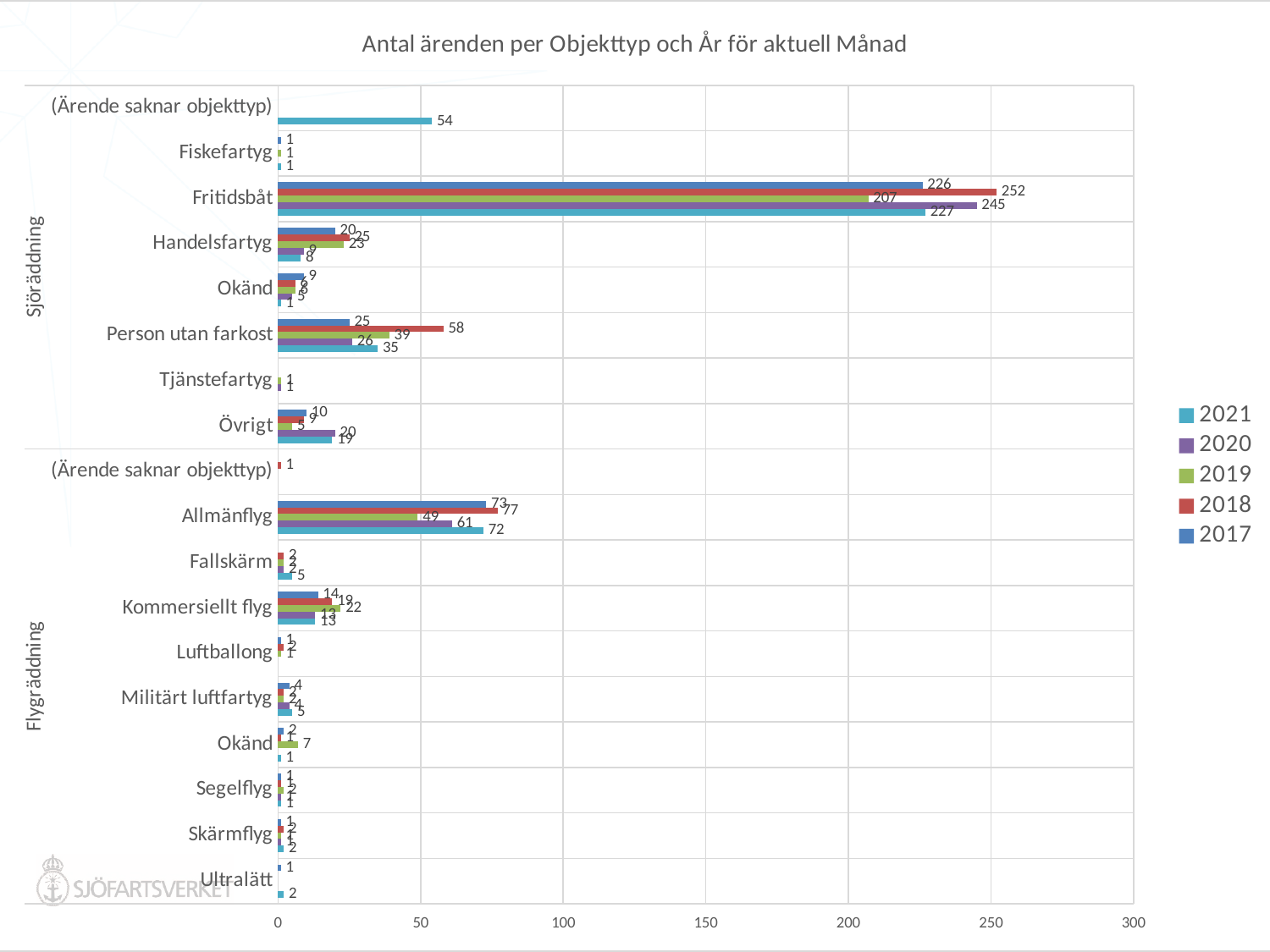
How many series does the legend list? 5 For Person utan farkost, which year has the larger value, 2018 or 2019? 2018 Which year has the highest value for Fritidsbåt? 2018 What is the difference between the 2018 and 2021 values for Allmänflyg? 5 What is the 2021 value for (Ärende saknar objekttyp) under Sjöräddning? 54 Which year has the lowest value for Fritidsbåt? 2019 What is the difference between the 2018 and 2019 values for Fritidsbåt? 45 What kind of chart is shown on the slide? bar chart What is the title of the chart? Antal ärenden per Objekttyp och År för aktuell Månad What is the value for Fritidsbåt in 2018? 252 What is the value for Allmänflyg in 2019? 49 Is the value for Allmänflyg in 2018 greater or less than 100? less